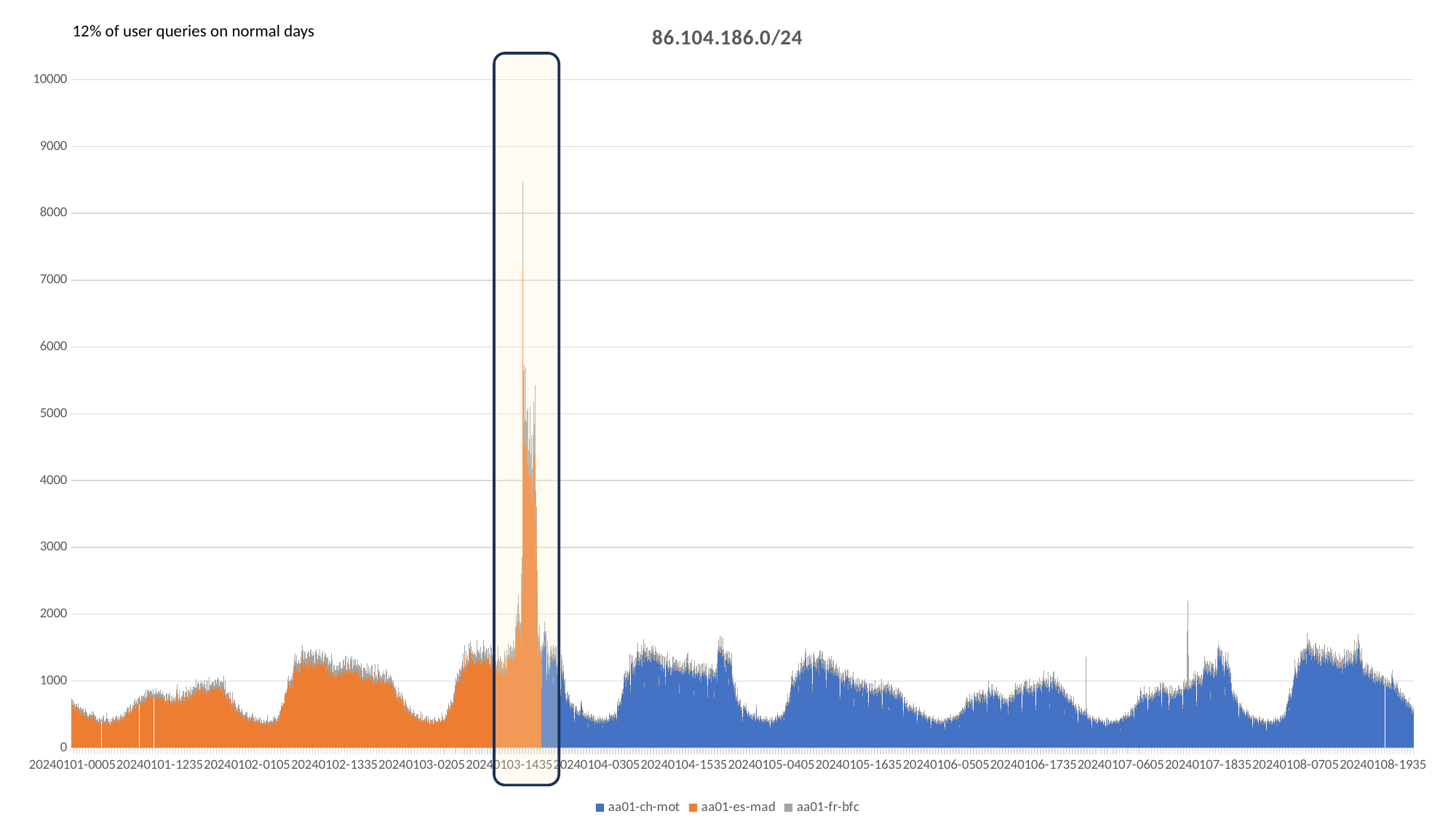
Around which x-axis label does the chart reach its highest value? 20240103-1435 Which series accounts for most of the stacked values in the right half of the chart (from 20240104-0305 onward)? aa01-ch-mot Is the highest peak of the chart (inside the highlighted box around 20240103-1435) greater or less than 8000? greater Which series is shown in orange in the legend? aa01-es-mad What is the title of the chart? 86.104.186.0/24 What kind of chart is shown on the slide? bar chart How many series does the chart legend list? 3 Is the stacked value at 20240105-0405 greater or less than 2000? less Is the stacked value at 20240102-0105 greater or less than 3000? less Which series accounts for most of the stacked values in the left part of the chart (before 20240103-1435)? aa01-es-mad